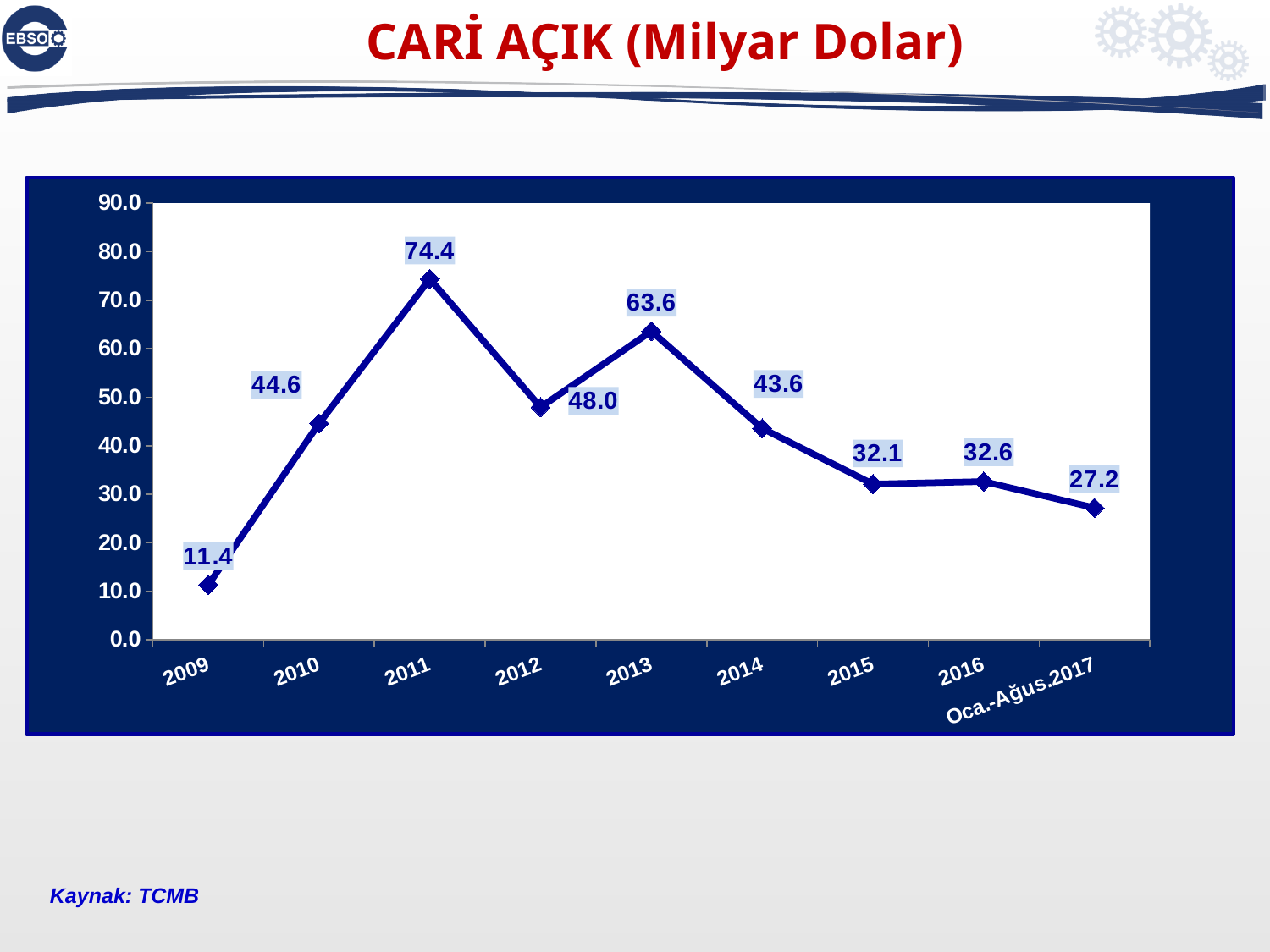
Which category has the lowest value? 2009 What is the value for 2009? 11.4 What kind of chart is shown on the slide? line chart Which is larger, the value for 2013 or the value for 2014? 2013 How many data points are plotted on the chart? 9 What is the value for 2011? 74.4 What is the value for Oca.-Ağus.2017? 27.2 Which year has the highest value? 2011 What is the title of the chart? CARİ AÇIK (Milyar Dolar) What is the difference between the values for 2011 and 2012? 26.4 Is the value for 2010 greater or less than 40.0? greater Do the values rise or fall from 2013 to 2015? fall